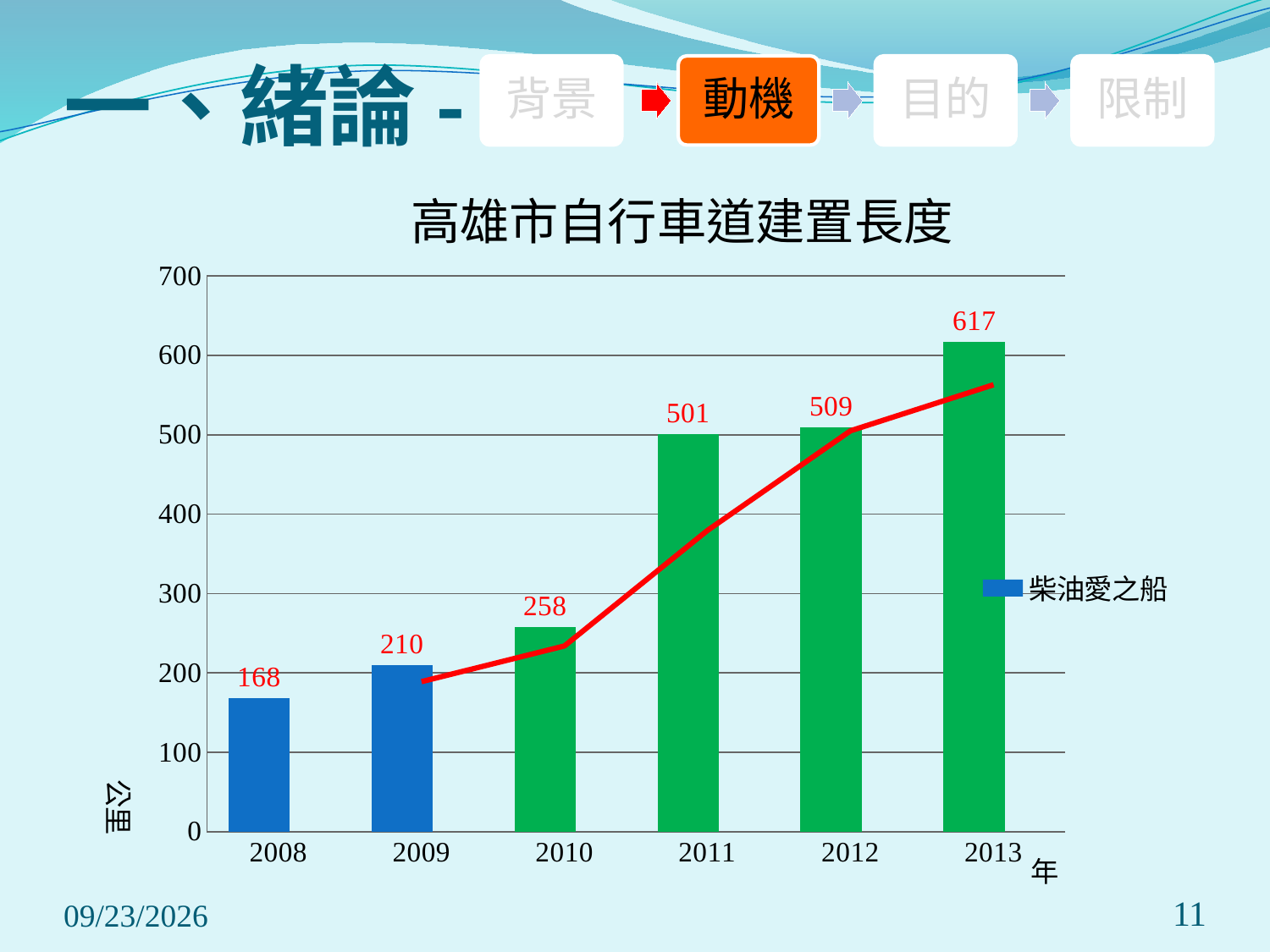
What kind of chart is shown on the slide? Bar chart Which is larger, the value for 2009 or the value for 2010? 2010 Do the bar values rise or fall from 2008 to 2013? Rise What is the difference between the values for 2013 and 2012? 108 How many years are shown on the x axis of the chart? 6 What is the title of the chart? 高雄市自行車道建置長度 What is the difference between the values for 2011 and 2010? 243 Which year has the lowest value in the chart? 2008 Which year has the highest value in the chart? 2013 What is the value for 2013 in the chart? 617 What is the value for 2010 in the chart? 258 What is the value for 2008 in the chart? 168